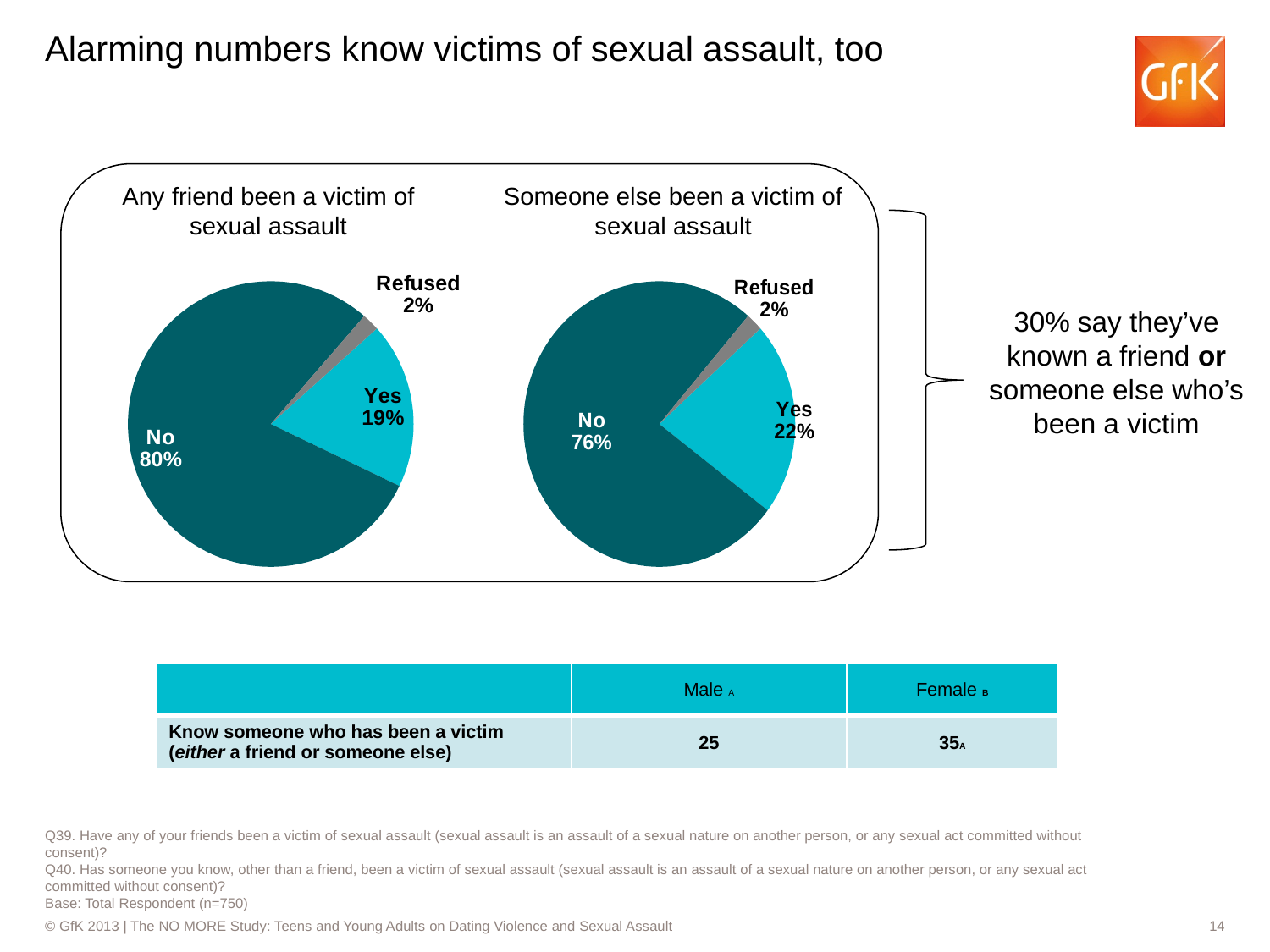
Which pie chart has the larger Yes share: 'Any friend been a victim of sexual assault' or 'Someone else been a victim of sexual assault'? Someone else been a victim of sexual assault In the 'Any friend been a victim of sexual assault' pie chart, which response has the largest slice? No In the 'Any friend been a victim of sexual assault' pie chart, what percentage answered Yes? 19% In the 'Someone else been a victim of sexual assault' pie chart, which response has the smallest slice? Refused In the 'Any friend been a victim of sexual assault' pie chart, what percentage Refused? 2% What type of chart is used to show responses to 'Any friend been a victim of sexual assault'? Pie chart In the 'Someone else been a victim of sexual assault' pie chart, what percentage answered No? 76% In the 'Any friend been a victim of sexual assault' pie chart, what percentage answered No? 80% How many slices does the 'Someone else been a victim of sexual assault' pie chart have? 3 In the 'Someone else been a victim of sexual assault' pie chart, what percentage answered Yes? 22% What is the difference between the No and Yes percentages in the 'Any friend been a victim of sexual assault' pie chart? 61% How many pie charts are shown on the slide? 2